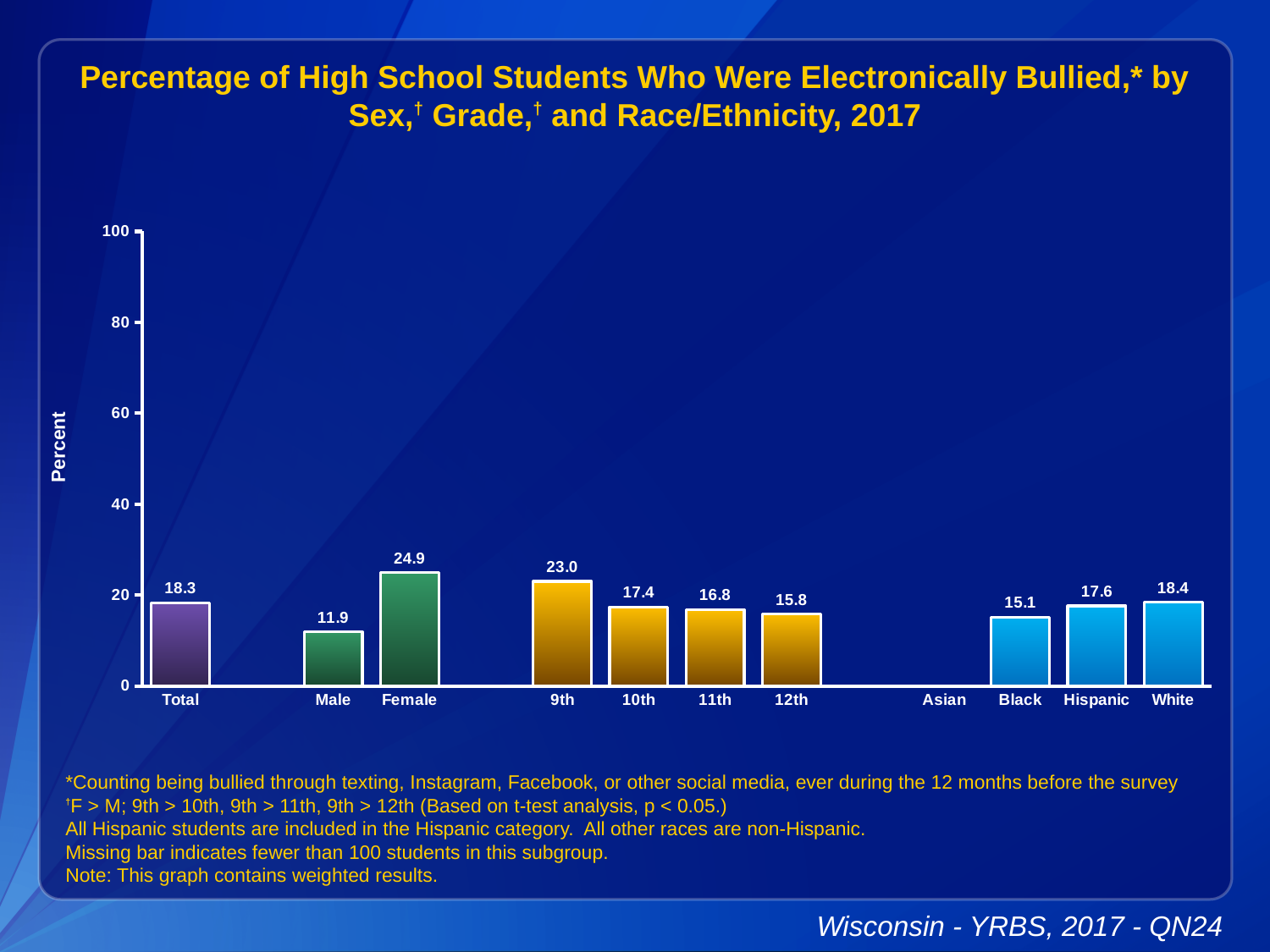
Which category has the highest value? Female What is the difference between the Female and Male values? 13.0 What is the value for Female? 24.9 What is the value for 12th grade? 15.8 Which is larger, the value for 9th grade or the value for 10th grade? 9th How many categories on the x axis have a bar plotted? 10 Which race/ethnicity category has no bar shown? Asian What kind of chart is shown? bar chart What is the value for Total? 18.3 Do the values fall or rise from 9th grade to 12th grade? fall Is the value for Female greater or less than 20? greater Which category with a bar has the lowest value? Male